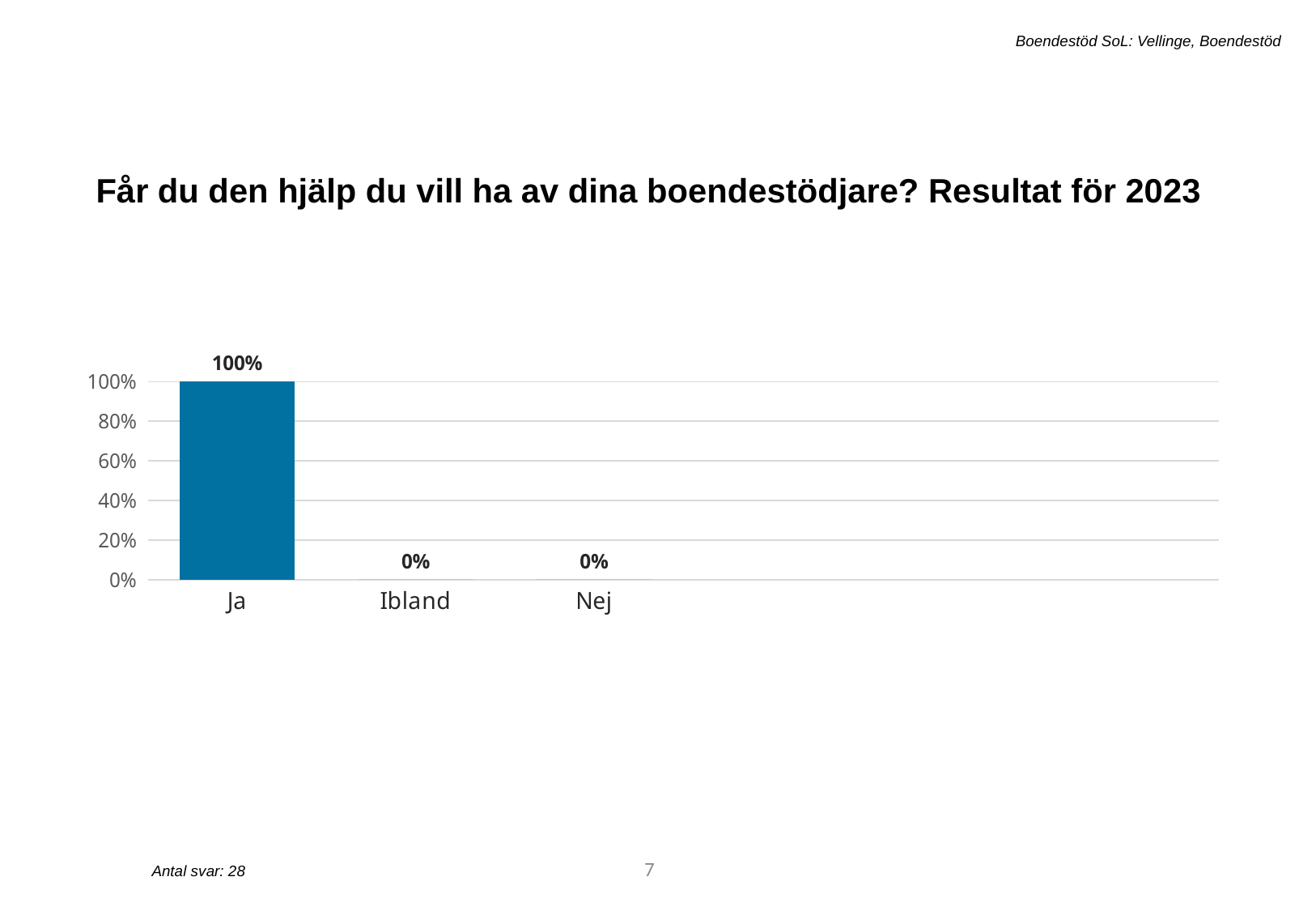
What is the value for Ja? 100% Which is larger, the value for Ja or the value for Ibland? Ja What is the value for Ibland? 0% What is the difference between the values for Ja and Nej? 100% How many responses (Antal svar) does the slide report? 28 How many categories are shown on the x axis? 3 Is the value for Ja greater or less than 80%? greater What is the title of the chart? Får du den hjälp du vill ha av dina boendestödjare? Resultat för 2023 Do the values rise or fall from Ja to Nej along the x axis? fall Which category has the highest value? Ja What kind of chart is shown on the slide? bar chart What is the value for Nej? 0%